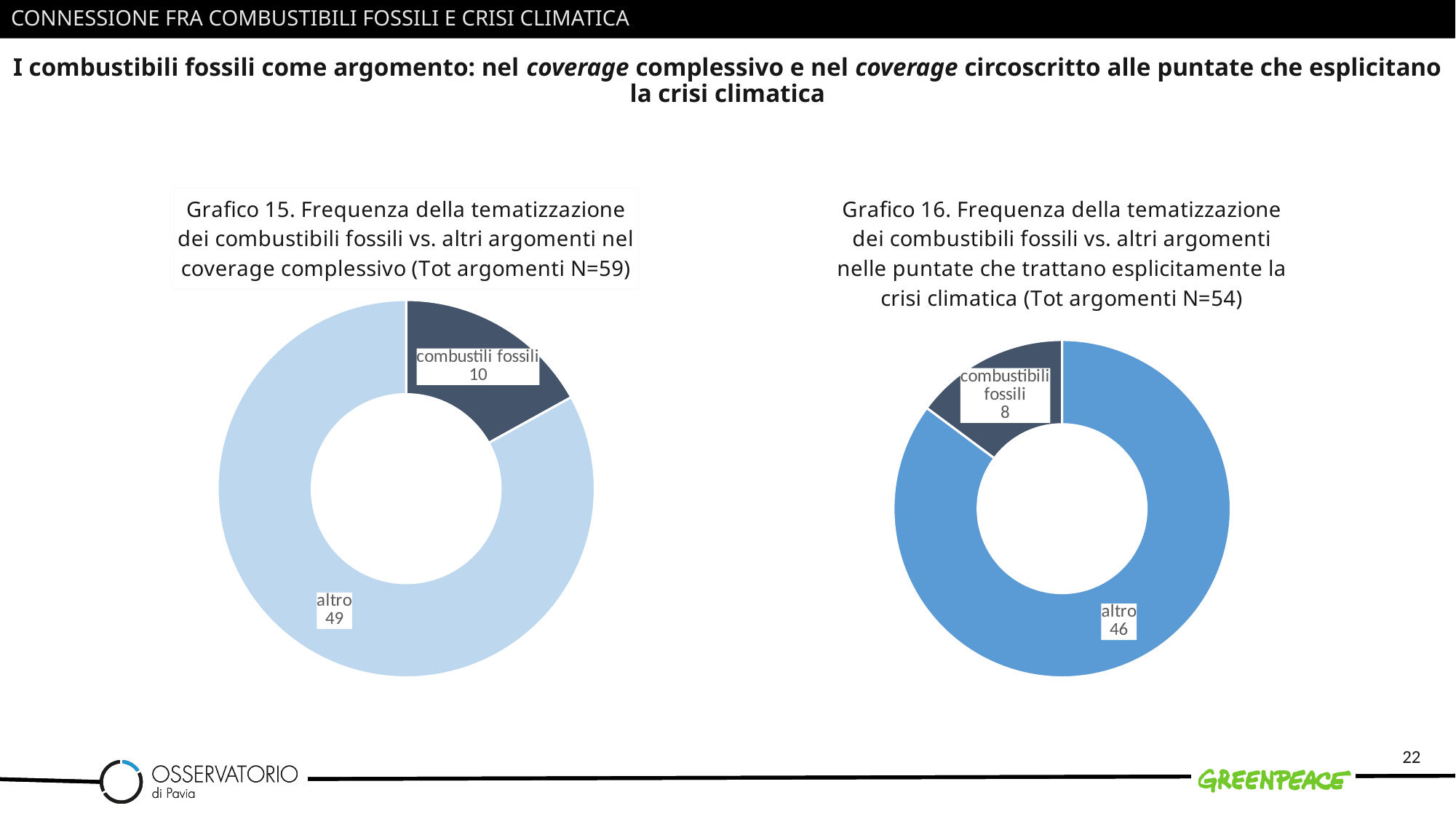
What kind of chart is Grafico 15? Doughnut (pie) chart In Grafico 16, what is the value for altro? 46 In Grafico 16, what is the difference between altro and combustibili fossili? 38 In Grafico 15, what is the value for altro? 49 In Grafico 15, what is the difference between altro and combustibili fossili? 39 How many categories are shown in Grafico 16? 2 In Grafico 15, which category has the largest slice? altro In Grafico 16, which category has the smallest slice? combustibili fossili Is the value for combustibili fossili larger in Grafico 15 or in Grafico 16? Grafico 15 In Grafico 15, what is the value for combustibili fossili? 10 What total number of argomenti (N) is stated in the title of Grafico 16? N=54 In Grafico 16, what is the value for combustibili fossili? 8